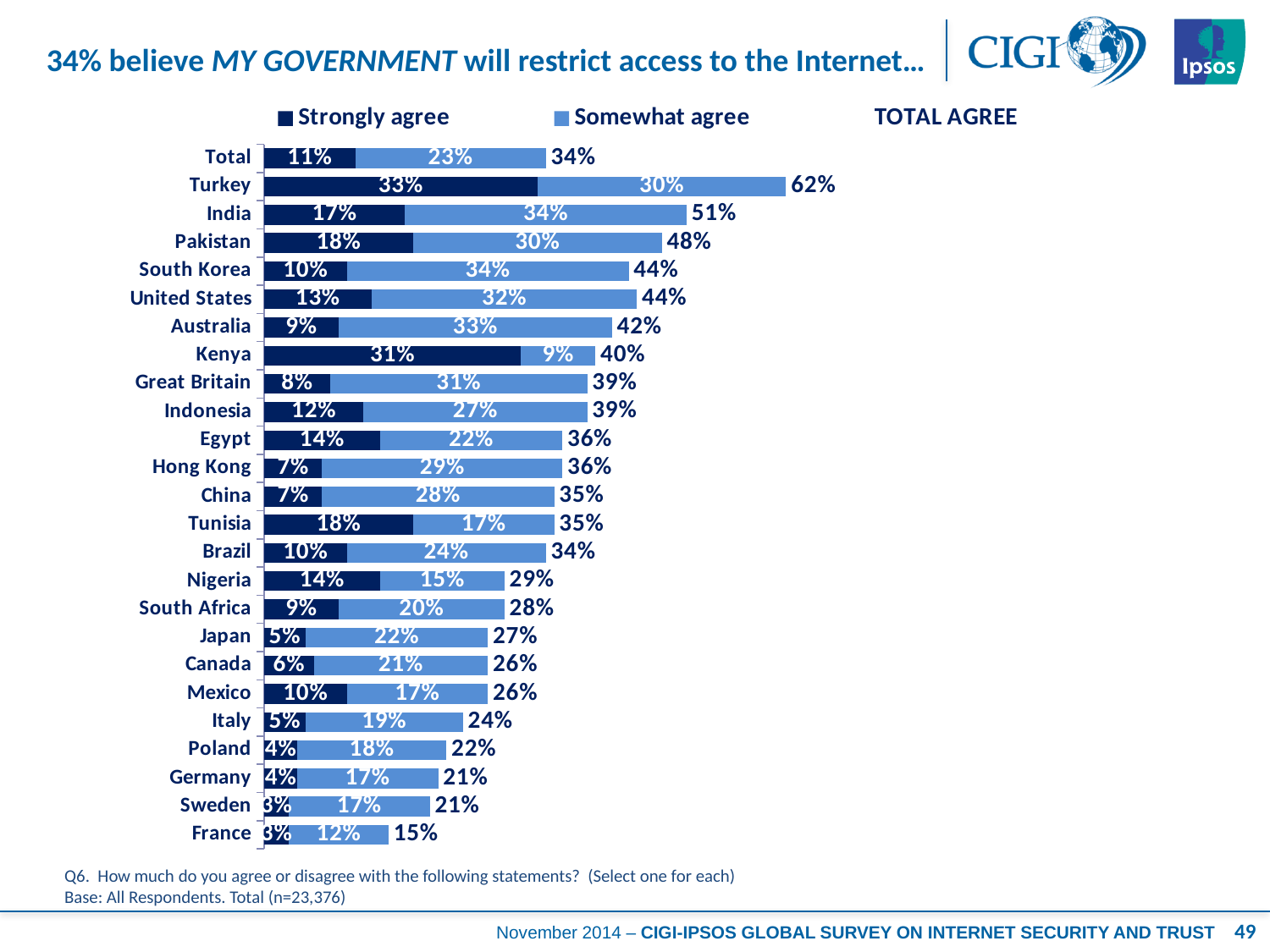
What is the total agree value for Kenya? 40% How many series does the legend list? 2 What is the total agree value for the Total row, combining 11% strongly agree and 23% somewhat agree? 34% What percentage of respondents in Turkey strongly agree that their government will restrict access to the Internet? 33% Which has a larger 'Strongly agree' value, Kenya or Egypt? Kenya Which country has the highest total agree value? Turkey What kind of chart is shown on the slide? Stacked bar chart How many categories (including Total) are shown on the chart? 25 What is the 'Somewhat agree' value for South Korea? 34% What is the difference between the total agree values for India and Pakistan? 3% Which country has the lowest total agree value? France Which colour represents 'Strongly agree' in the chart? Dark navy blue